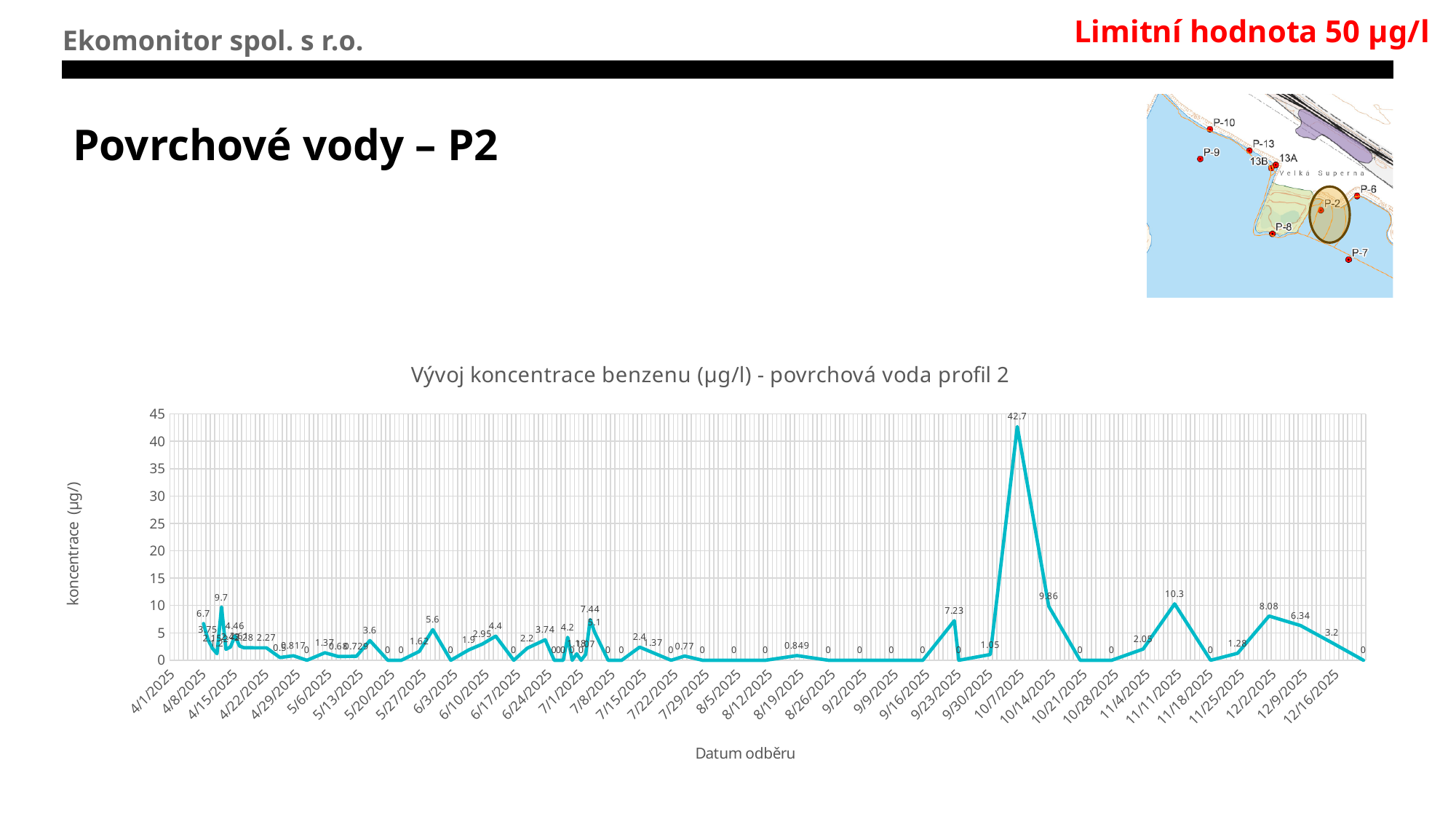
What is the benzene concentration value labelled at 10/7/2025? 42.7 What is the difference between the value at 10/7/2025 (42.7) and the value at 11/11/2025 (10.3)? 32.4 What is the benzene concentration value labelled at 11/11/2025? 10.3 What is the title of the chart? Vývoj koncentrace benzenu (µg/l) - povrchová voda profil 2 What is the label of the y axis? koncentrace (µg/l) What is the benzene concentration value labelled at 12/2/2025? 8.08 What is the highest benzene concentration value plotted on the chart? 42.7 Is the peak value on the chart greater or less than 40? greater Do the values rise or fall between 10/7/2025 and 10/21/2025? fall What is the benzene concentration value labelled at 12/9/2025? 6.34 What kind of chart is shown on the slide? line chart Which is larger, the value at 10/7/2025 or the value at 11/11/2025? 10/7/2025